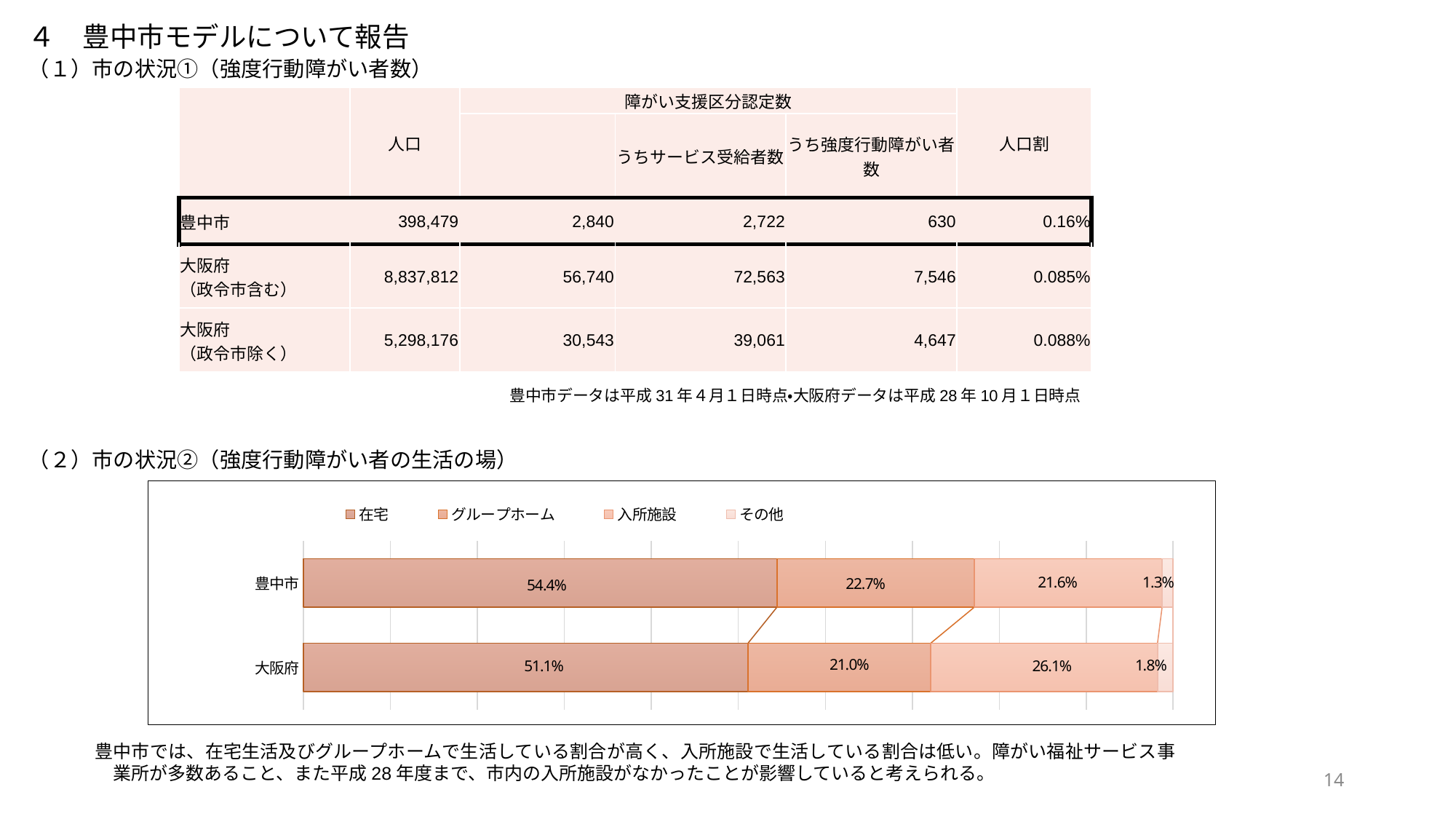
In the stacked bar chart, which series has the largest share for 豊中市? 在宅 In the stacked bar chart, what is the 在宅 share for 豊中市? 54.4% In the stacked bar chart, what is the difference between the 入所施設 shares of 大阪府 and 豊中市? 4.5% In the stacked bar chart, what is the その他 share for 豊中市? 1.3% In the stacked bar chart, what is the グループホーム share for 大阪府? 21.0% In the stacked bar chart, which has the larger 在宅 share, 豊中市 or 大阪府? 豊中市 What kind of chart is shown in section (2) 市の状況②? stacked bar chart In the stacked bar chart, which series has the smallest share for 大阪府? その他 In the stacked bar chart, what is the 入所施設 share for 大阪府? 26.1% How many series does the legend of the stacked bar chart list? 4 How many categories (bars) are shown in the stacked bar chart? 2 In the stacked bar chart, what is the combined share of 在宅 and グループホーム for 豊中市? 77.1%